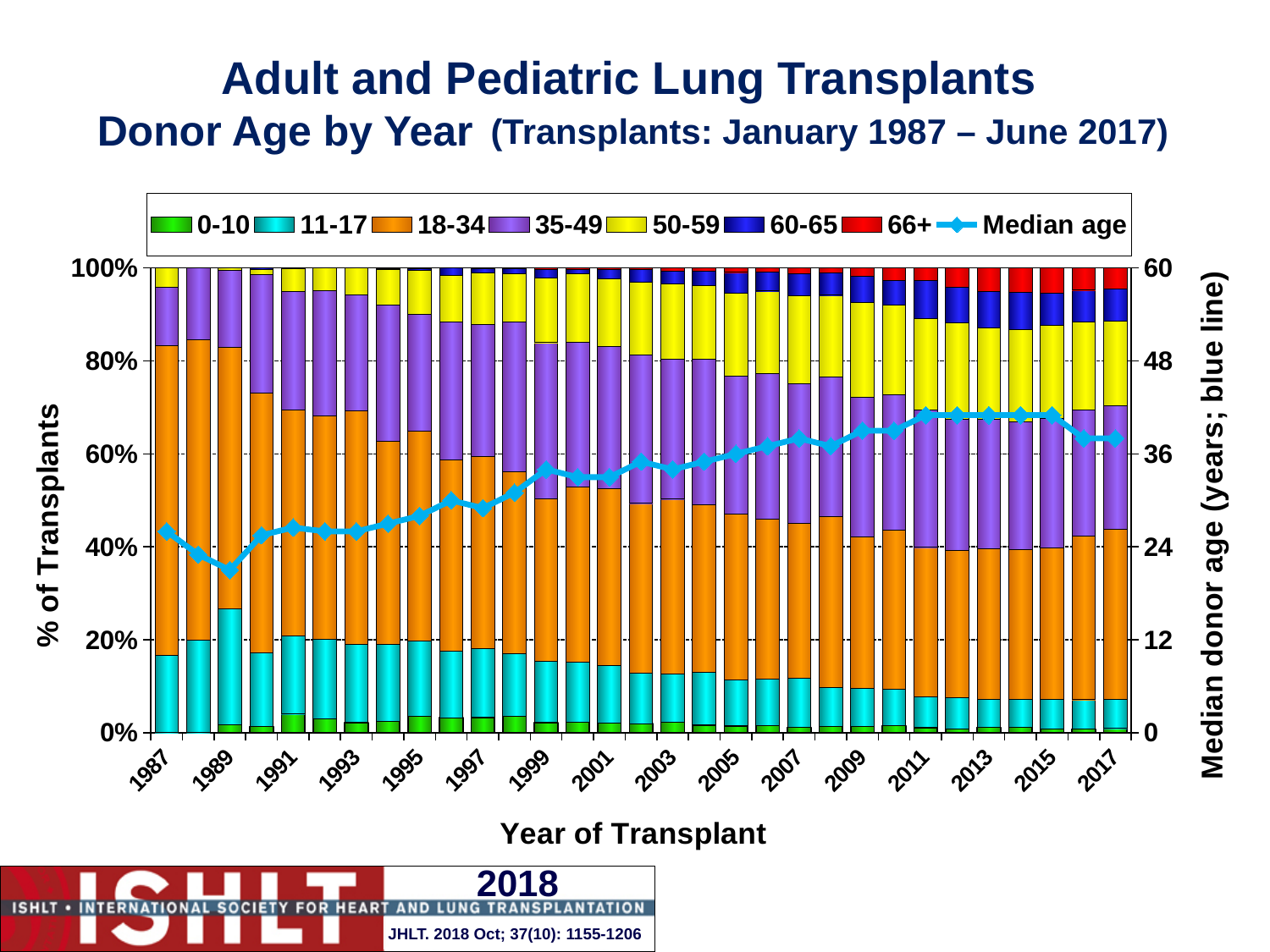
What does each stacked bar total on the left axis? 100% What is the label of the x axis? Year of Transplant How many entries does the legend list? 8 What kind of chart is shown on the slide? Stacked bar chart with a line Is the median donor age in 1989 greater or less than 24 years? less Overall, does the median donor age line rise or fall from 1987 to 2017? rise Is the median donor age in 2012 greater or less than 36 years? greater Is the median donor age in 1999 greater or less than 24 years? greater Is the share of 18-34 year old donors larger in 1987 or in 2017? 1987 Is the median donor age in 2011 larger or smaller than in 1989? larger How many years (bars) are plotted along the x axis? 31 What is the label of the right-hand y axis? Median donor age (years; blue line)